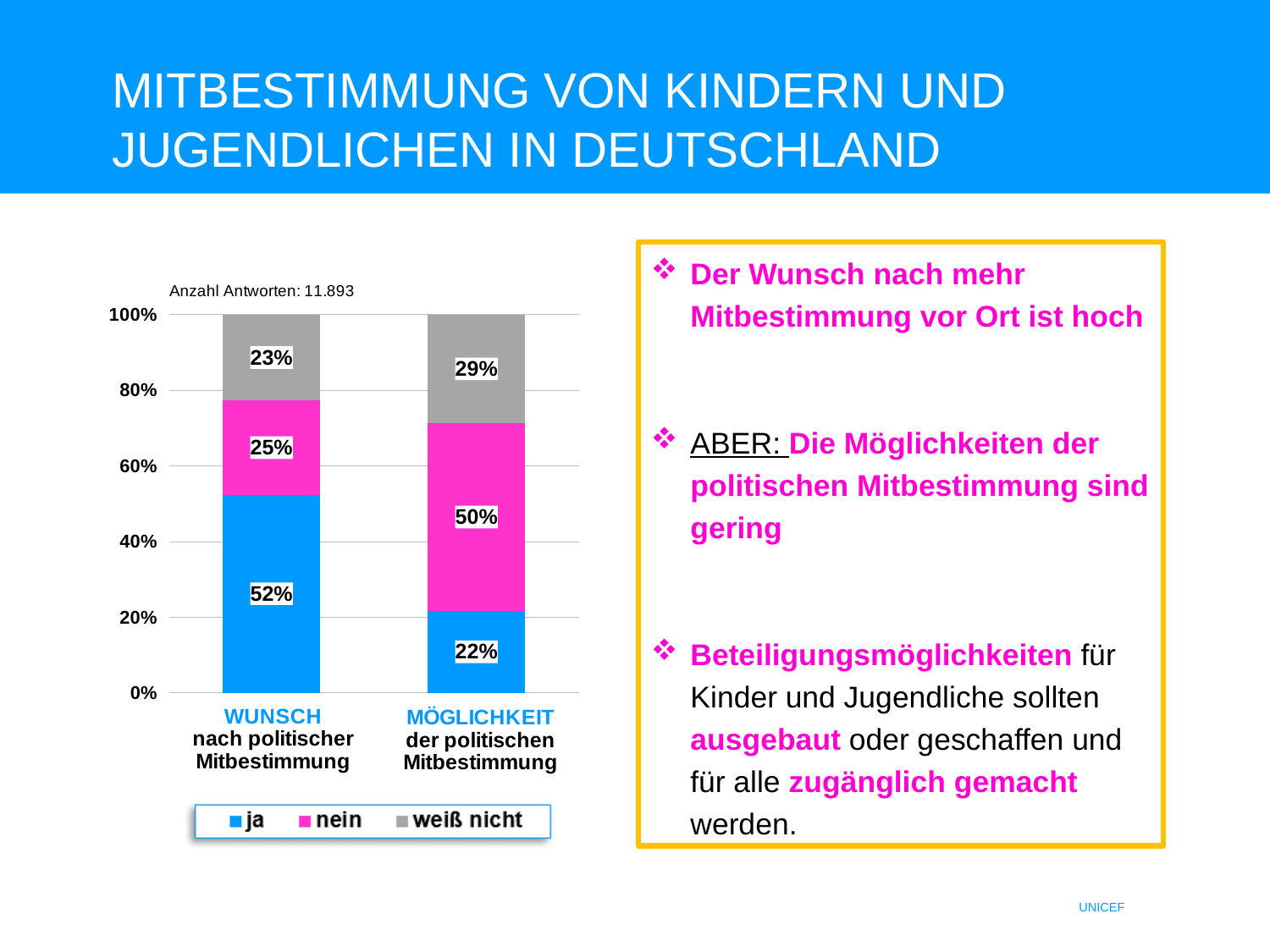
What is the 'ja' value for 'WUNSCH nach politischer Mitbestimmung'? 52% Which category has the higher 'ja' value? WUNSCH nach politischer Mitbestimmung How many categories are shown on the x axis? 2 What kind of chart is shown? Stacked bar chart What number of responses (Anzahl Antworten) is stated above the chart? 11.893 What is the 'nein' value for 'MÖGLICHKEIT der politischen Mitbestimmung'? 50% What is the 'weiß nicht' value for 'WUNSCH nach politischer Mitbestimmung'? 23% What is the difference between the 'ja' values of 'WUNSCH nach politischer Mitbestimmung' and 'MÖGLICHKEIT der politischen Mitbestimmung'? 30% What is the 'ja' value for 'MÖGLICHKEIT der politischen Mitbestimmung'? 22% How many series does the legend list? 3 Is the 'weiß nicht' value larger for 'WUNSCH nach politischer Mitbestimmung' or for 'MÖGLICHKEIT der politischen Mitbestimmung'? MÖGLICHKEIT der politischen Mitbestimmung Which category has the lower 'nein' value? WUNSCH nach politischer Mitbestimmung